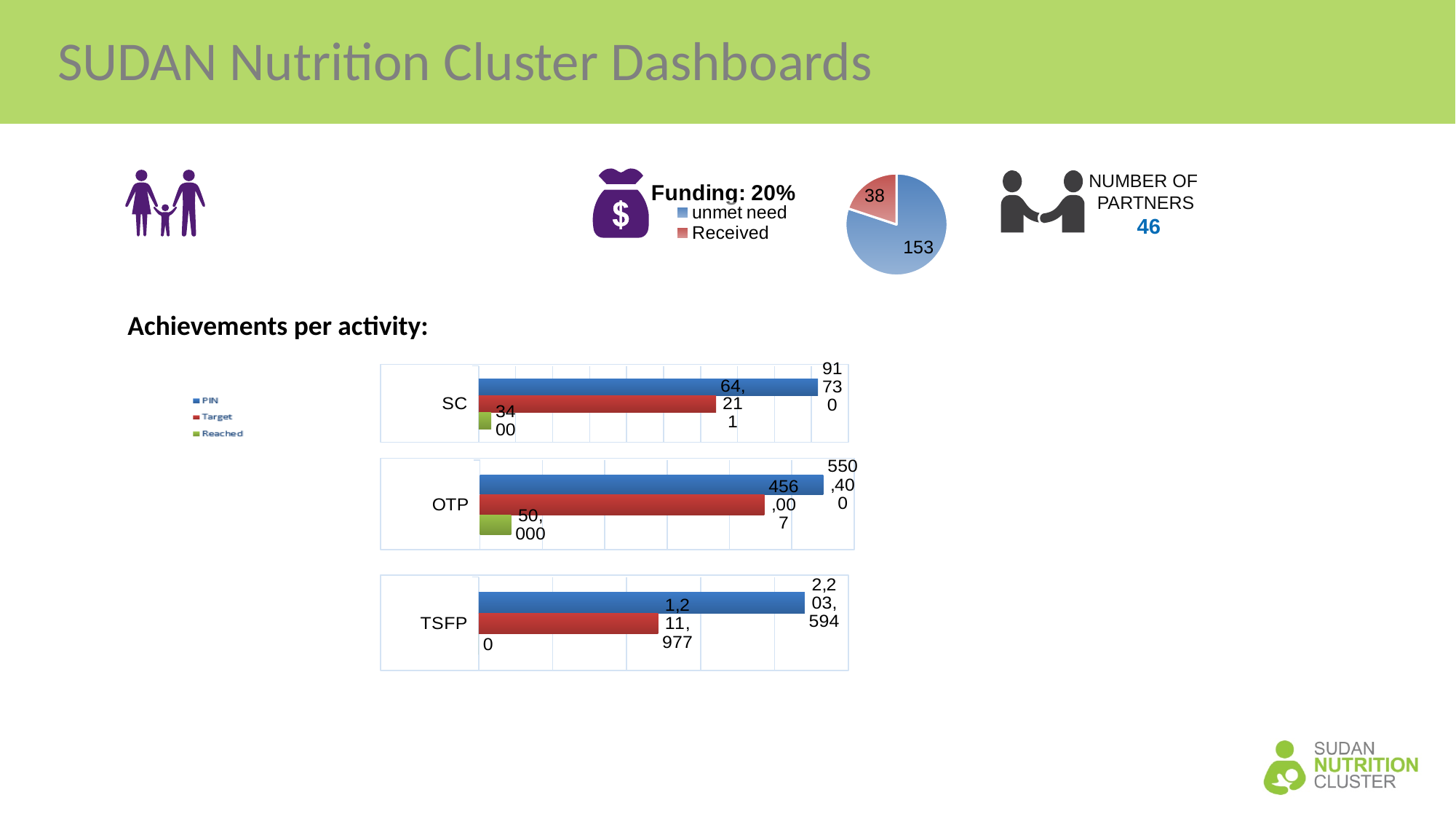
How many entries does the legend of the Funding pie chart list? 2 In the TSFP bar chart, what is the difference between PIN and Target? 991,617 In the Funding pie chart, what is the difference between unmet need and Received? 115 In the Funding pie chart, what is the value for Received? 38 In the OTP bar chart, what is the PIN value? 550,400 In the OTP bar chart, what is the Reached value? 50,000 In the OTP bar chart, what is the Target value? 456,007 In the Funding pie chart, what is the value for unmet need? 153 How many series does the legend of the Achievements per activity bar charts list? 3 In the TSFP bar chart, what is the Reached value? 0 In the TSFP bar chart, what is the PIN value? 2,203,594 In the SC bar chart, which is larger, PIN or Target? PIN